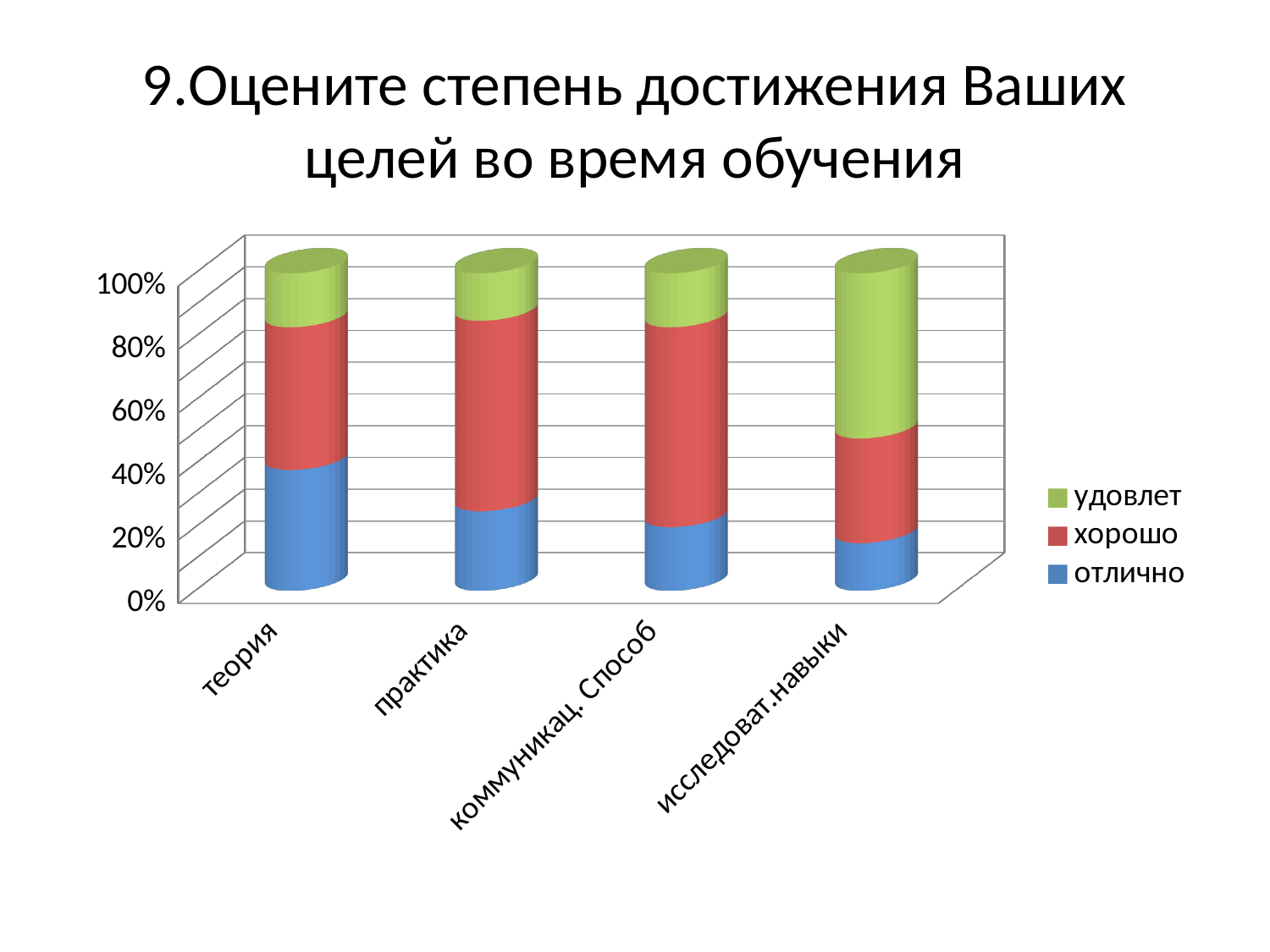
How many categories are shown on the x axis of the chart? 4 What kind of chart is shown on the slide? stacked bar chart Is the share for отлично in теория larger or smaller than in практика? larger How many series does the legend list? 3 Is the share for хорошо in коммуникац. Способ larger or smaller than in исследоват.навыки? larger Which colour represents the series отлично in the chart? blue Is the value for хорошо in практика greater or less than 40%? greater Is the value for отлично in теория greater or less than 20%? greater Which category has the largest share for удовлет? исследоват.навыки Is the share for удовлет in исследоват.навыки larger or smaller than in теория? larger Which category has the smallest share for хорошо? исследоват.навыки Which category has the largest share for отлично? теория